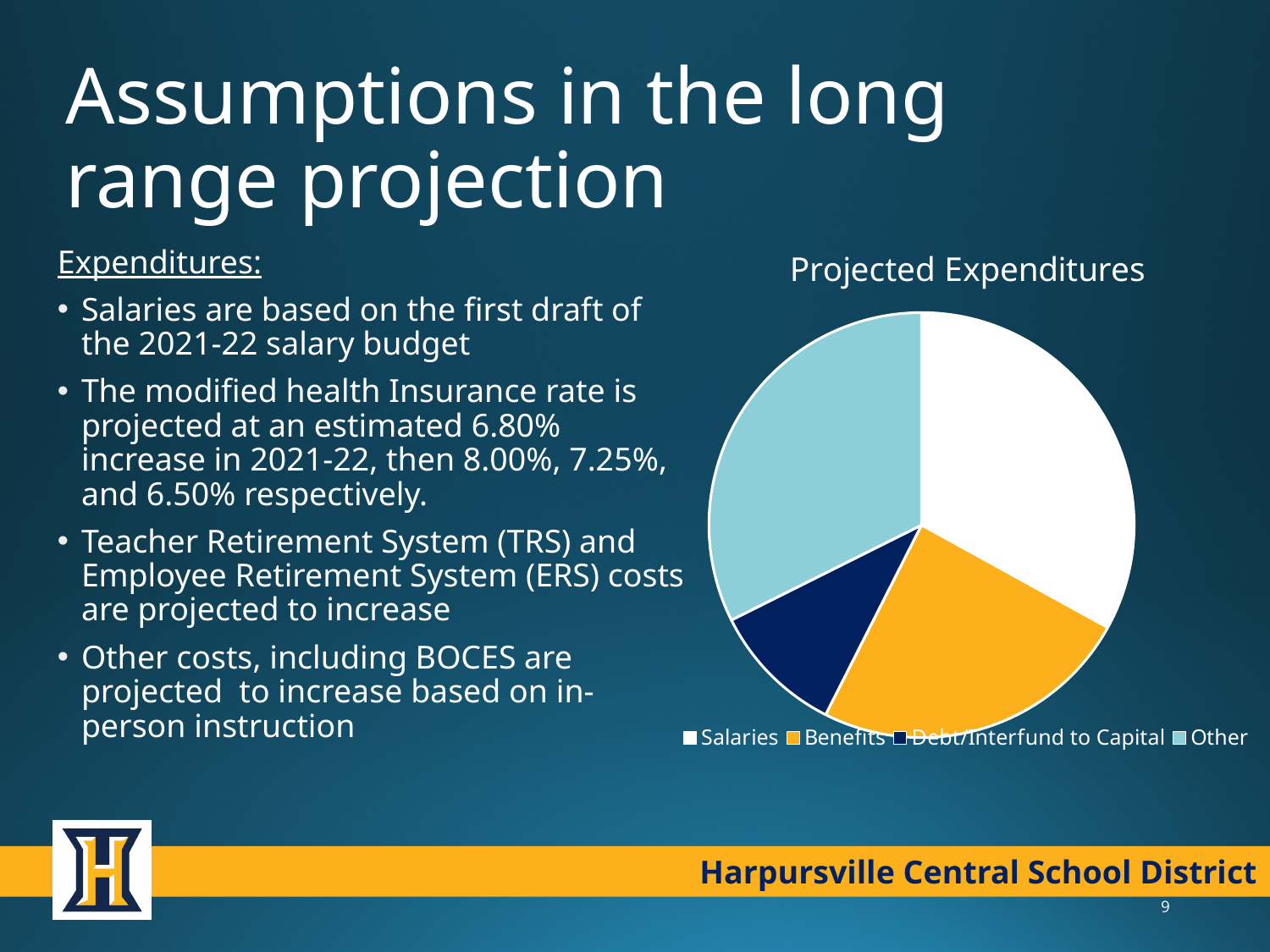
How many slices does the Projected Expenditures pie chart have? 4 Which category has the smallest slice in the Projected Expenditures pie chart? Debt/Interfund to Capital How many entries does the legend of the Projected Expenditures chart list? 4 In the Projected Expenditures chart, which slice is larger, Benefits or Debt/Interfund to Capital? Benefits In the Projected Expenditures chart, which slice is larger, Other or Debt/Interfund to Capital? Other What kind of chart is shown on the slide? pie chart Which category is shown in orange in the Projected Expenditures pie chart? Benefits What is the title of the chart on the slide? Projected Expenditures In the Projected Expenditures chart, which slice is larger, Salaries or Benefits? Salaries